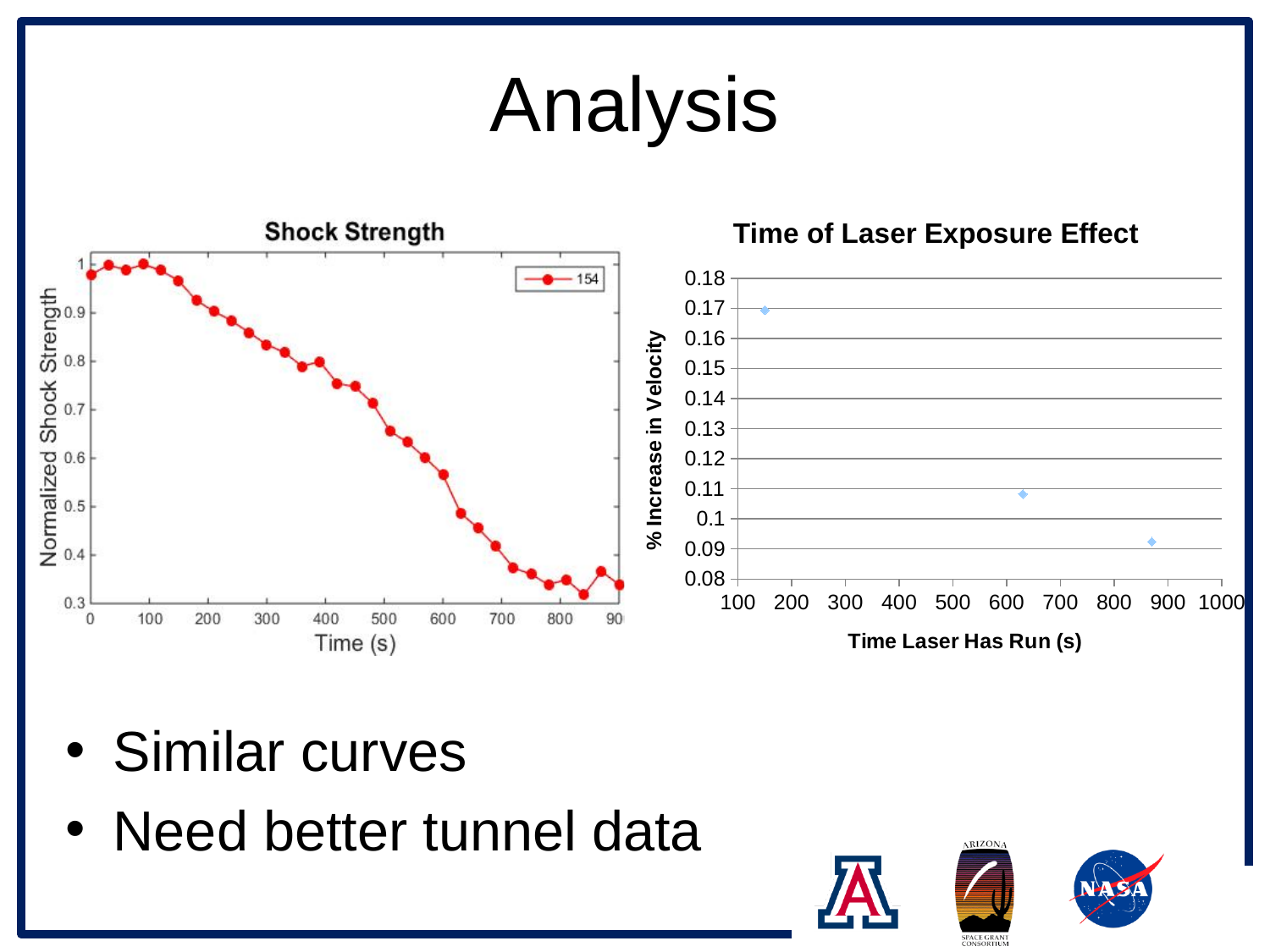
In the Shock Strength chart, does the normalized shock strength rise or fall as time increases? fall In the Time of Laser Exposure Effect chart, do the values rise or fall as the time the laser has run increases? fall What label does the legend of the Shock Strength chart show? 154 In the Time of Laser Exposure Effect chart, is the % increase in velocity for the leftmost point greater or less than 0.16? greater In the Time of Laser Exposure Effect chart, is the % increase in velocity for the rightmost point greater or less than 0.1? less In the Time of Laser Exposure Effect chart, which point has the higher % increase in velocity, the leftmost or the rightmost? the leftmost In the Time of Laser Exposure Effect chart, is the % increase in velocity for the middle point greater or less than 0.1? greater What is the x-axis title of the Time of Laser Exposure Effect chart? Time Laser Has Run (s) What kind of chart is the Time of Laser Exposure Effect chart? scatter chart What kind of chart is the Shock Strength chart? line chart In the Time of Laser Exposure Effect chart, how many data points are plotted? 3